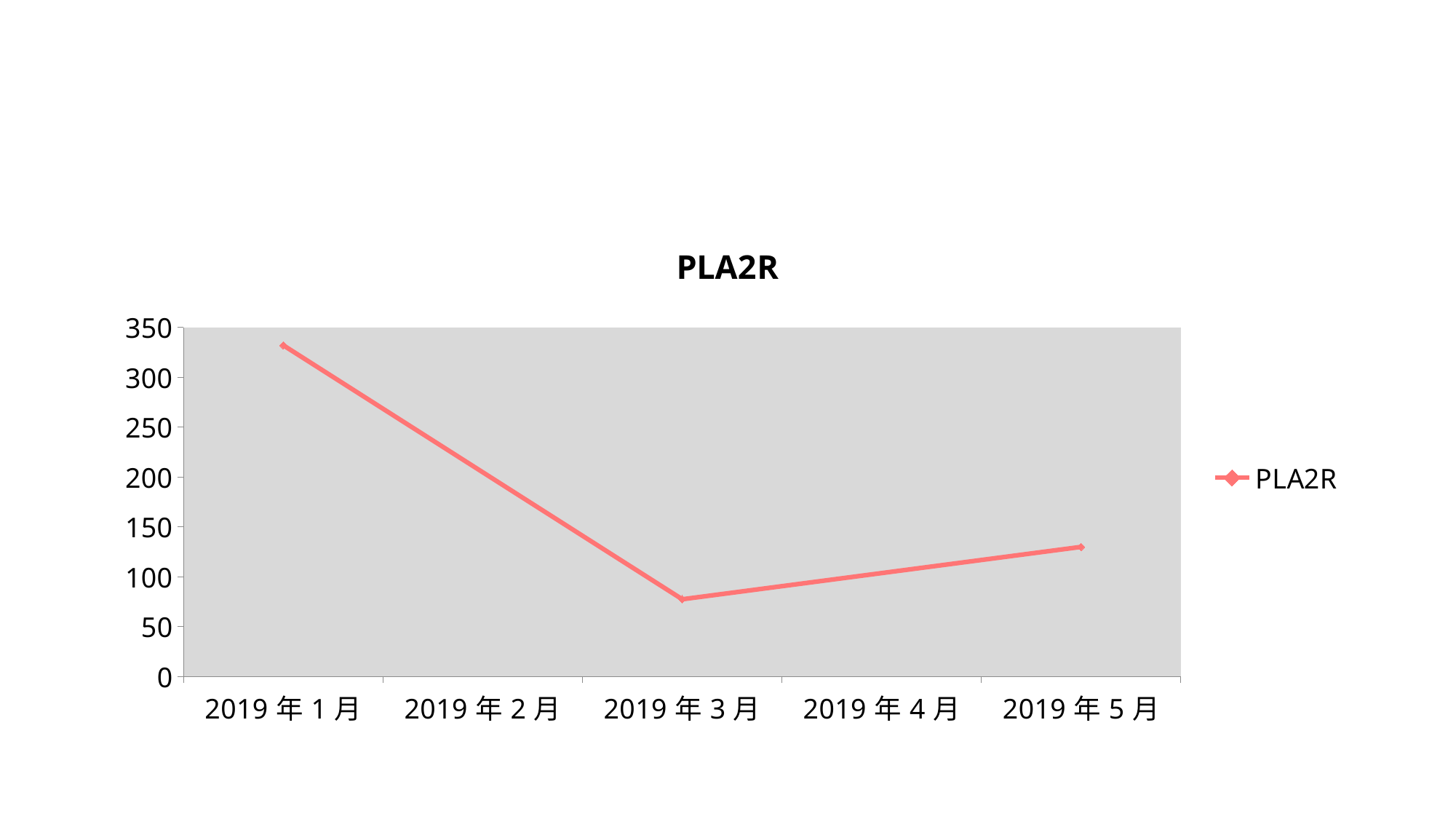
Which month has the highest PLA2R value? 2019年1月 Which is larger, the PLA2R value for 2019年1月 or for 2019年5月? 2019年1月 How many categories are labelled on the x axis? 5 Which is larger, the PLA2R value for 2019年3月 or for 2019年5月? 2019年5月 Is the PLA2R value for 2019年1月 greater or less than 300? greater How does the PLA2R value change from 2019年1月 to 2019年3月? It falls Is the PLA2R value for 2019年3月 greater or less than 100? less How many series does the legend list? 1 Which month has the lowest PLA2R value? 2019年3月 Is the PLA2R value for 2019年5月 greater or less than 150? less What is the title of the chart? PLA2R What kind of chart is shown on the slide? line chart